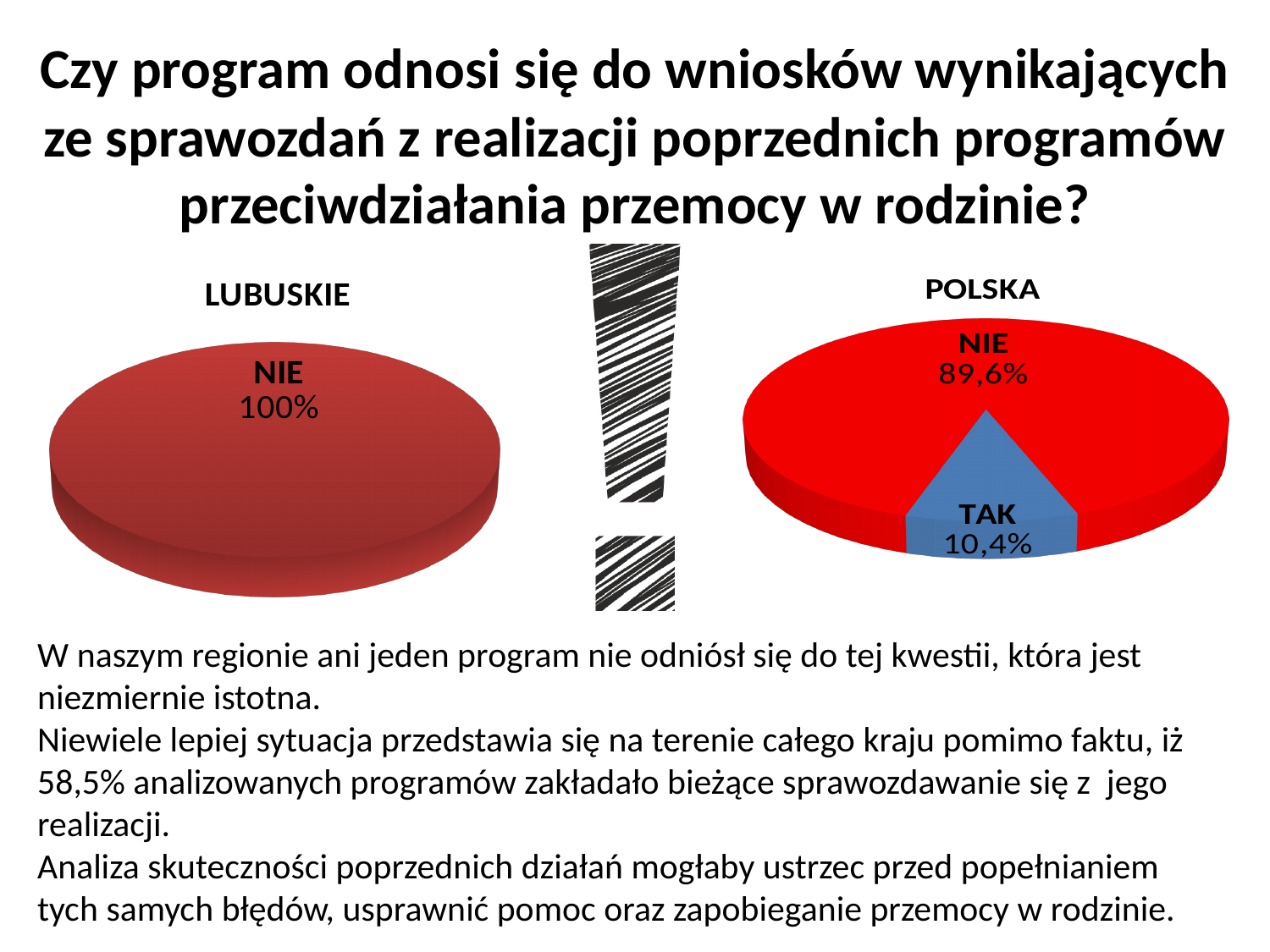
In the POLSKA chart, what colour is the TAK slice? Blue How many slices does the POLSKA chart have? 2 In the POLSKA chart, which slice is the largest? NIE In the POLSKA chart, what is the difference between the NIE and TAK values? 79,2% What kind of chart is the LUBUSKIE chart? Pie chart In the LUBUSKIE chart, what is the value for NIE? 100% In the POLSKA chart, what is the value for NIE? 89,6% In the POLSKA chart, what is the value for TAK? 10,4% In the POLSKA chart, which is larger, NIE or TAK? NIE In the POLSKA chart, what share of the pie does TAK take? 10,4% How many slices does the LUBUSKIE chart have? 1 In the POLSKA chart, which slice is the smallest? TAK